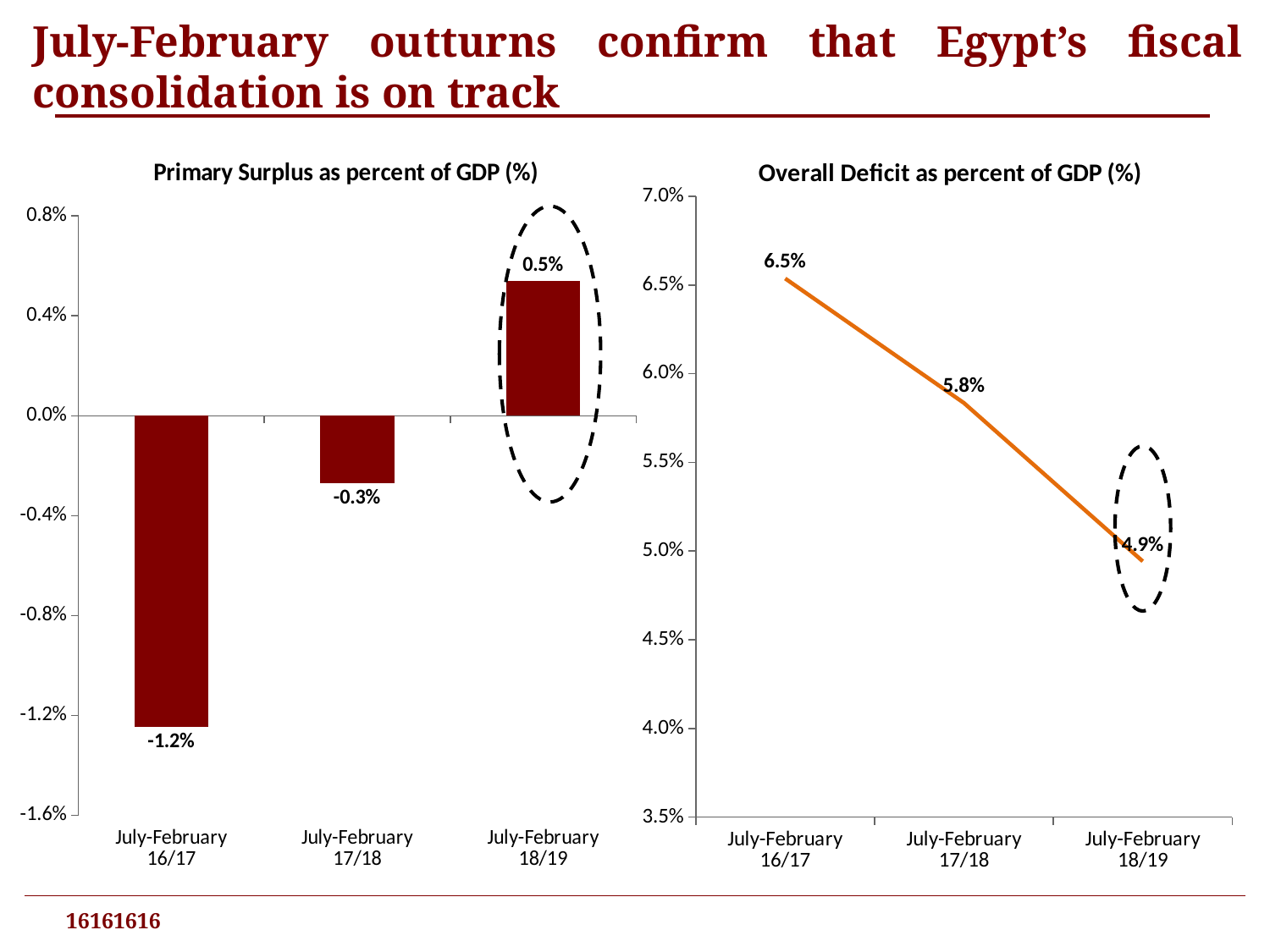
In the 'Overall Deficit as percent of GDP (%)' chart, do the values rise or fall from July-February 16/17 to July-February 18/19? Fall In the 'Overall Deficit as percent of GDP (%)' chart, what is the value for July-February 18/19? 4.9% In the 'Overall Deficit as percent of GDP (%)' chart, what is the difference between the July-February 16/17 and July-February 18/19 values? 1.6% In the 'Primary Surplus as percent of GDP (%)' chart, what is the value for July-February 18/19? 0.5% In the 'Primary Surplus as percent of GDP (%)' chart, which period has the lowest value? July-February 16/17 What kind of chart is the 'Primary Surplus as percent of GDP (%)' chart? Bar chart In the 'Overall Deficit as percent of GDP (%)' chart, which period has the highest value? July-February 16/17 In the 'Overall Deficit as percent of GDP (%)' chart, what is the value for July-February 17/18? 5.8% In the 'Primary Surplus as percent of GDP (%)' chart, what is the difference between the July-February 18/19 and July-February 17/18 values? 0.8% In the 'Primary Surplus as percent of GDP (%)' chart, which is larger: the value for July-February 17/18 or July-February 18/19? July-February 18/19 What kind of chart is the 'Overall Deficit as percent of GDP (%)' chart? Line chart In the 'Primary Surplus as percent of GDP (%)' chart, what is the value for July-February 16/17? -1.2%